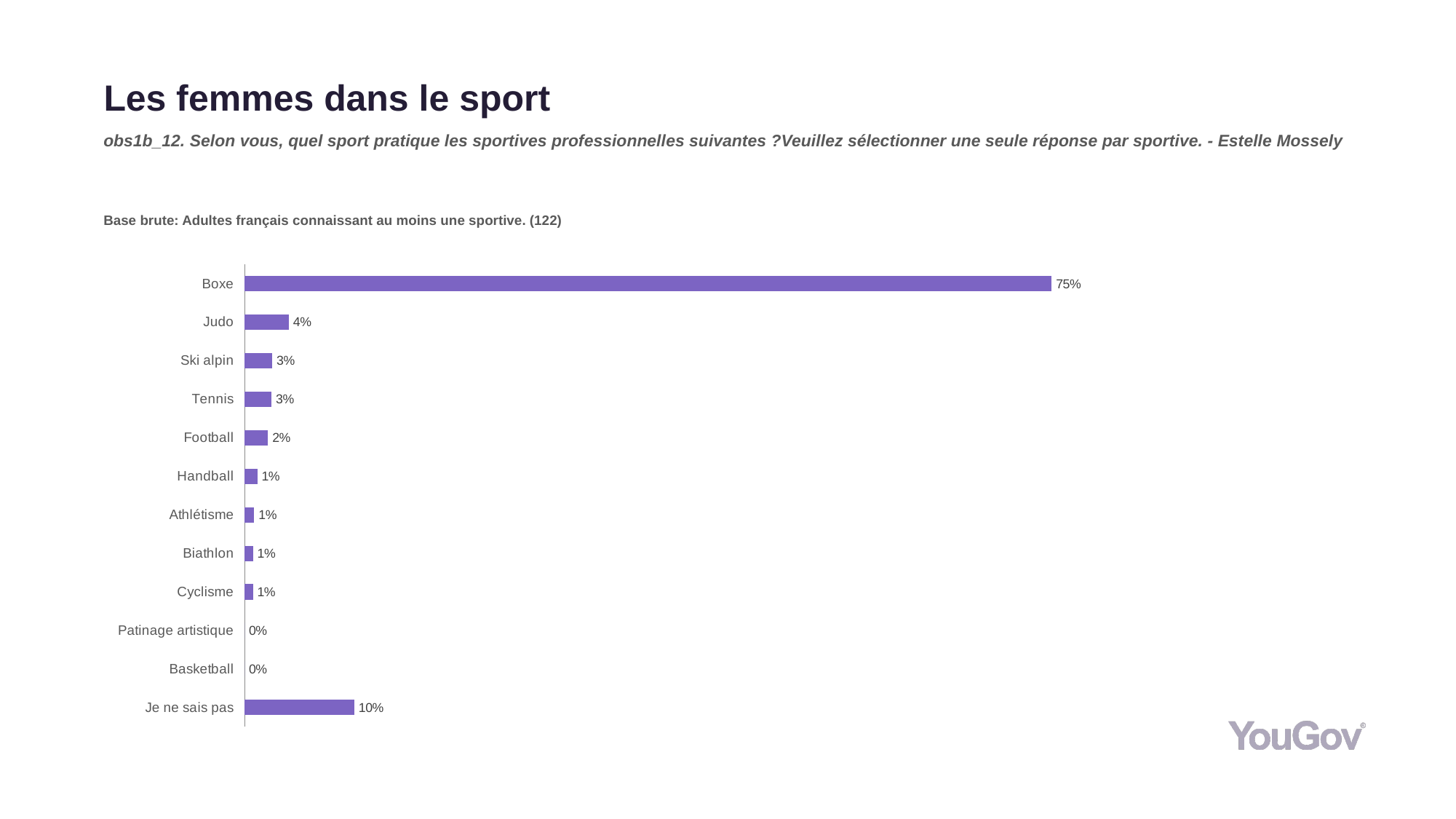
Which category has the highest value? Boxe What kind of chart is shown on the slide? Bar chart How many categories are shown on the chart? 12 What is the difference between the values for Boxe and Je ne sais pas? 65 percentage points What is the value shown for Judo? 4% What percentage of respondents answered Boxe? 75% Which two categories show a value of 0%? Patinage artistique and Basketball What is the value shown for Football? 2% Which is larger, the value for Judo or the value for Tennis? Judo Which is larger, the value for Je ne sais pas or the value for Ski alpin? Je ne sais pas What is the value shown for Je ne sais pas? 10% What is the difference between the values for Judo and Football? 2 percentage points